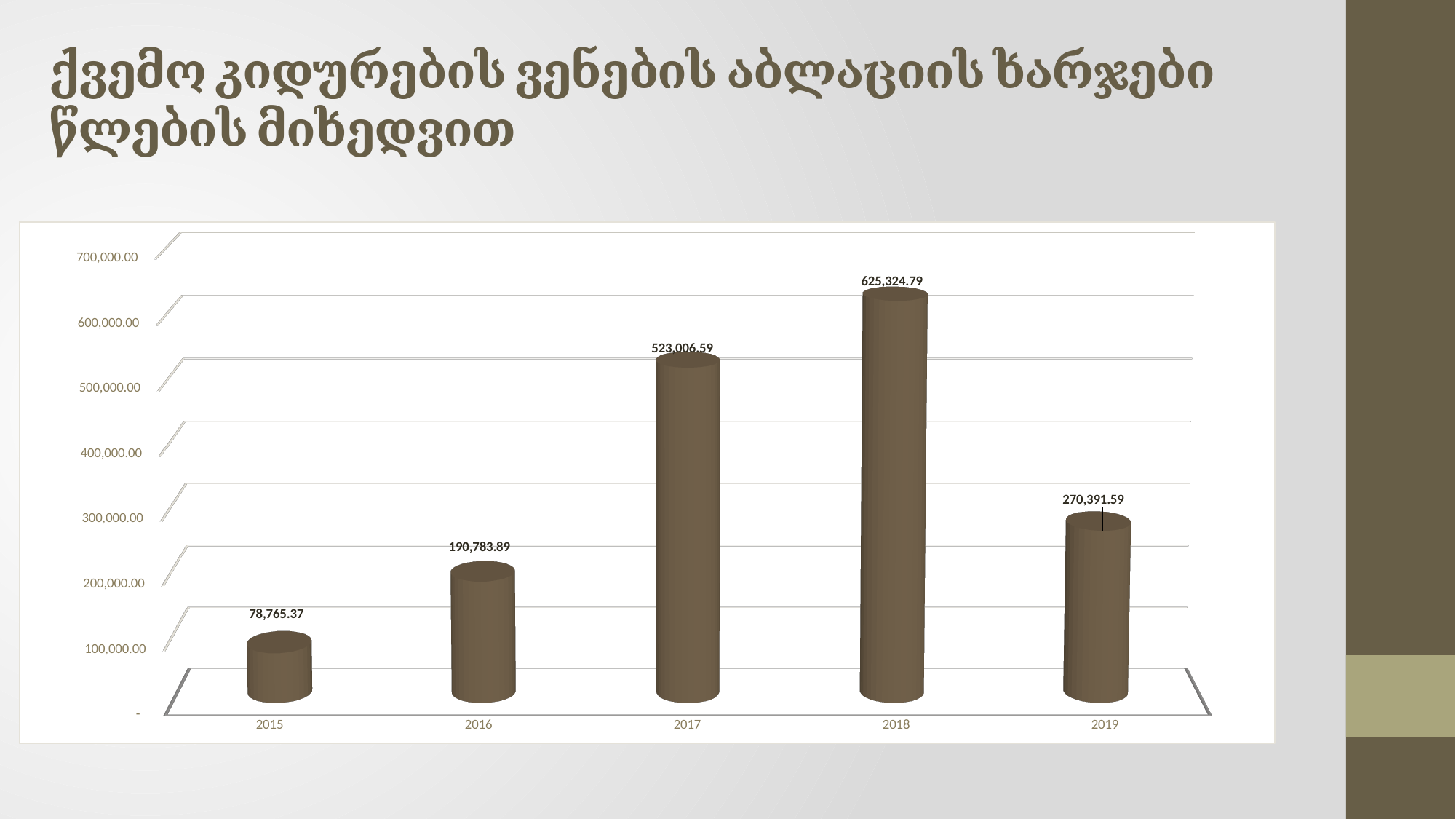
What is the value for 2019? 270,391.59 How many years are shown on the x axis? 5 What is the difference between the values for 2019 and 2016? 79,607.70 What kind of chart is shown on the slide? bar chart Which year has the lowest value? 2015 Is the value for 2018 greater or less than 600,000.00? greater What is the difference between the values for 2018 and 2017? 102,318.20 What is the value for 2015? 78,765.37 What is the value for 2017? 523,006.59 Which year has the highest value? 2018 Which is larger, the value for 2016 or the value for 2019? 2019 Do the values rise or fall from 2015 to 2018? rise